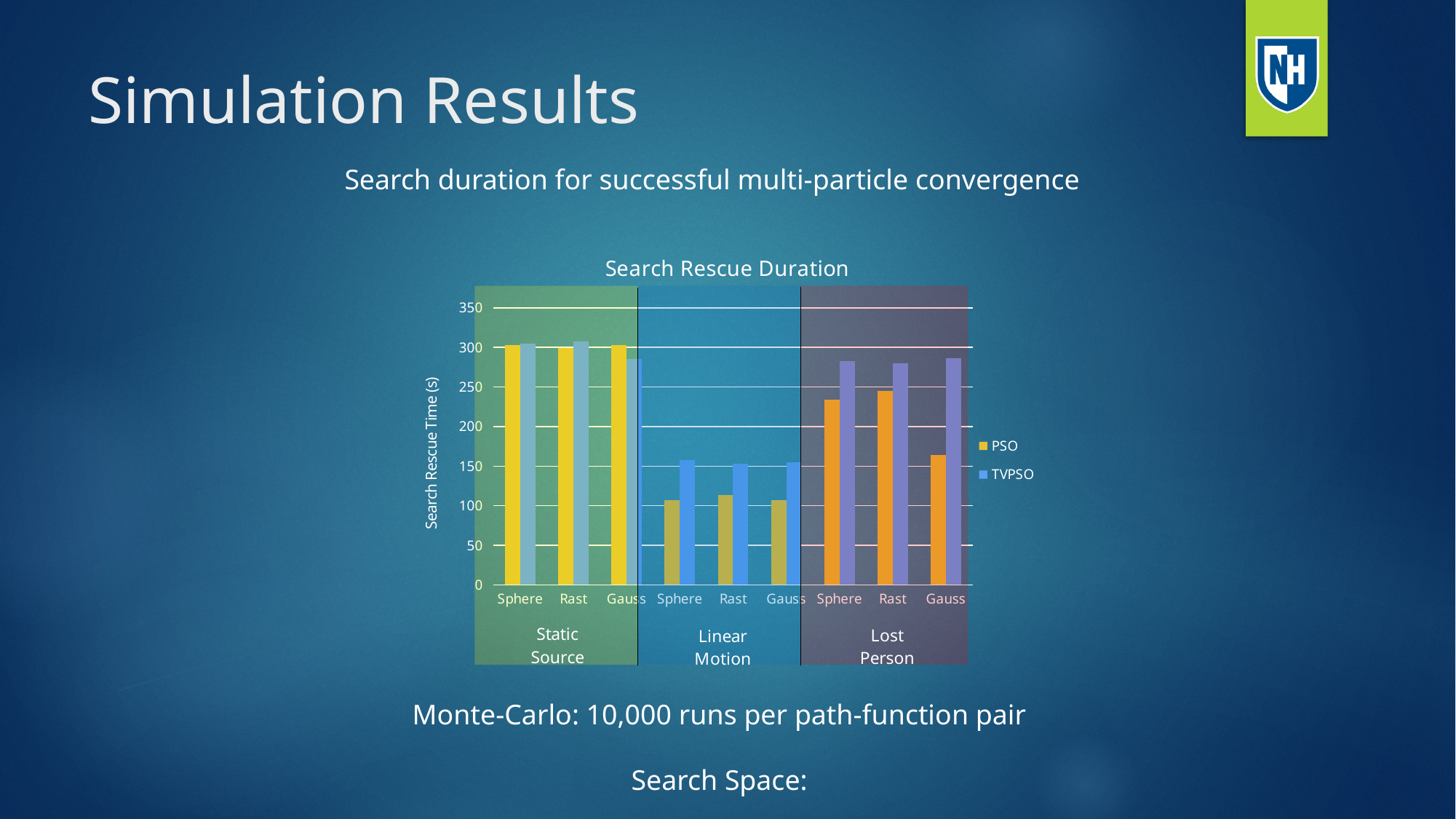
Within the Lost Person group, which function has the lowest PSO value? Gauss Is the PSO value for Sphere under Static Source greater or less than 250? greater Is the TVPSO value for Sphere under Lost Person greater or less than 250? greater What are the two series named in the legend? PSO and TVPSO Under Linear Motion, which is larger for Gauss: PSO or TVPSO? TVPSO Under Lost Person, which is larger for Sphere: PSO or TVPSO? TVPSO Is the PSO value for Sphere under Linear Motion greater or less than 150? less How many series does the chart legend list? 2 How many category groups (bar pairs) are plotted along the x axis? 9 What is the title of the chart? Search Rescue Duration What kind of chart is shown on the slide? bar chart